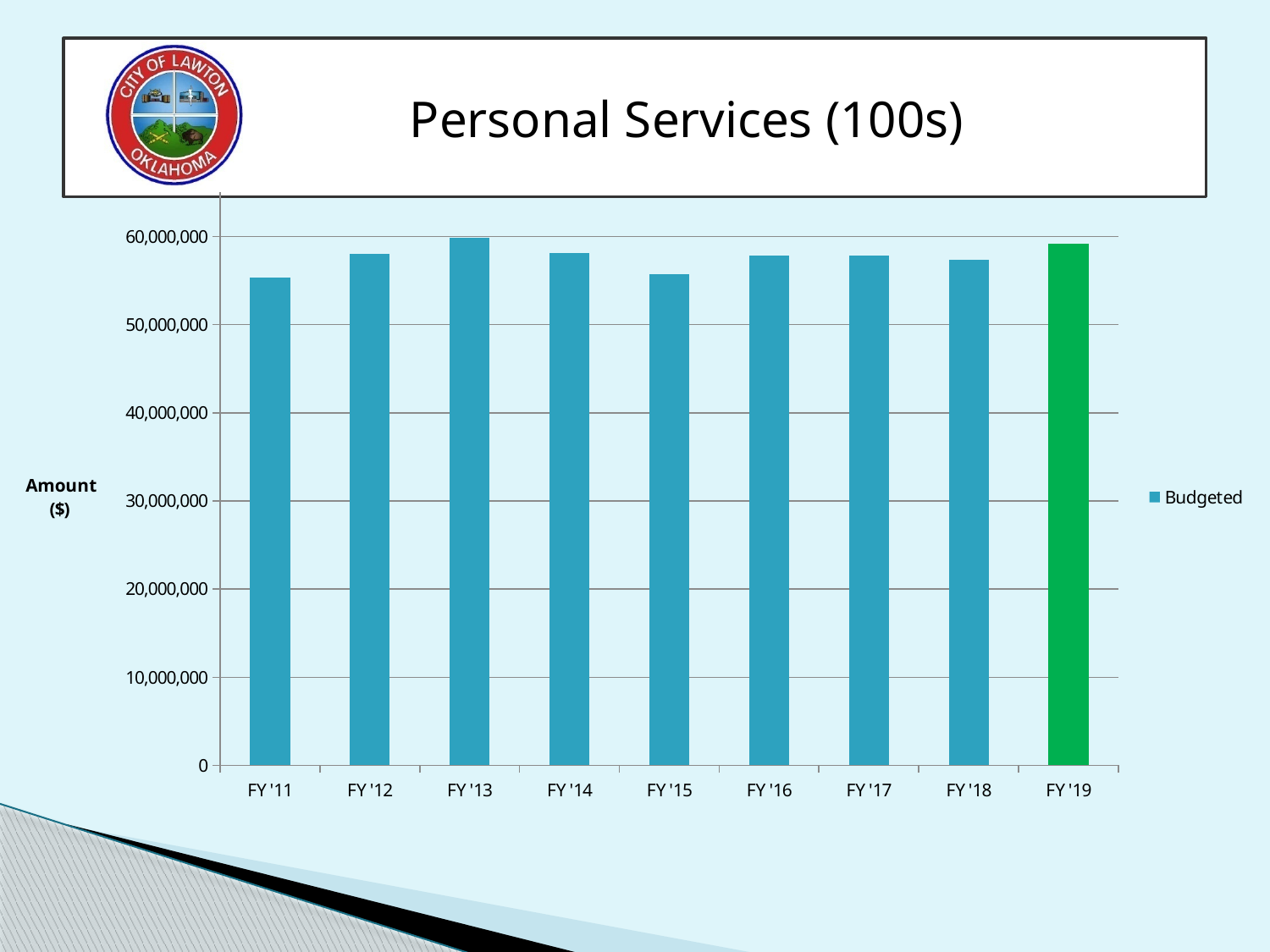
How many fiscal years are plotted on the chart? 9 Is the value for FY '18 greater or less than 50,000,000? greater Which is larger, the value for FY '19 or the value for FY '18? FY '19 Which bar is shown in a different colour (green) from the others? FY '19 How many series does the legend list? 1 What is the name of the series shown in the legend? Budgeted Is the value for FY '15 greater or less than 60,000,000? less Which is larger, the value for FY '13 or the value for FY '11? FY '13 Is the value for FY '11 greater or less than 50,000,000? greater Which is larger, the value for FY '12 or the value for FY '15? FY '12 Does the value rise or fall from FY '18 to FY '19? rise What kind of chart is shown on the slide? bar chart